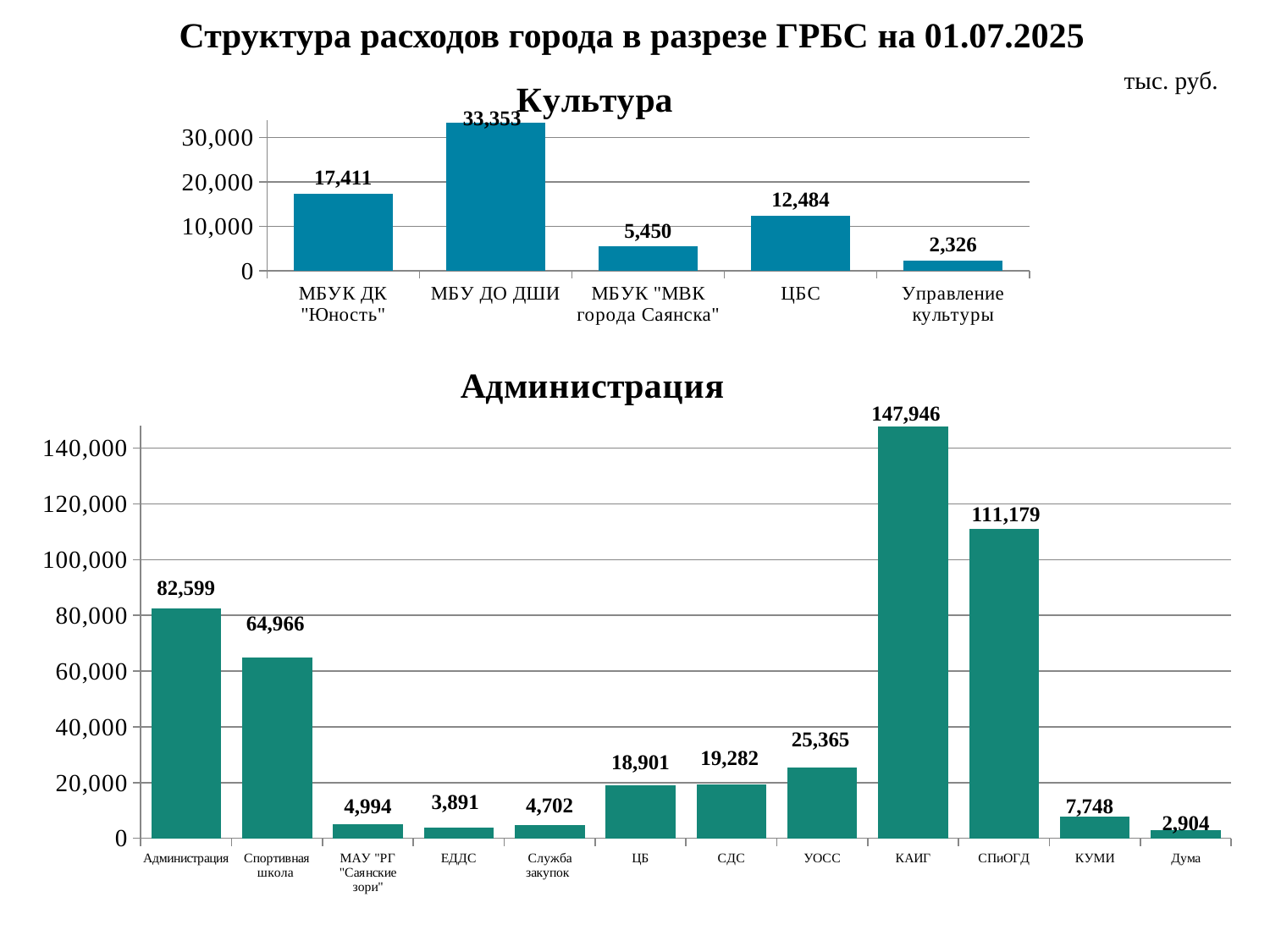
In the "Культура" chart, which category has the lowest value? Управление культуры In the "Администрация" chart, what is the value for Спортивная школа? 64,966 In the "Культура" chart, what is the value for МБУ ДО ДШИ? 33,353 What kind of chart is the "Администрация" chart? Bar chart In the "Культура" chart, what is the difference between the values for МБУК ДК "Юность" and ЦБС? 4,927 In the "Администрация" chart, which category has the lowest value? Дума In the "Администрация" chart, how many categories are shown? 12 In the "Культура" chart, how many categories are shown? 5 What unit is stated for the values on the slide? тыс. руб. In the "Администрация" chart, which is larger, the value for ЦБ or the value for УОСС? УОСС In the "Администрация" chart, what is the value for КАИГ? 147,946 In the "Администрация" chart, what is the difference between the values for КАИГ and СПиОГД? 36,767